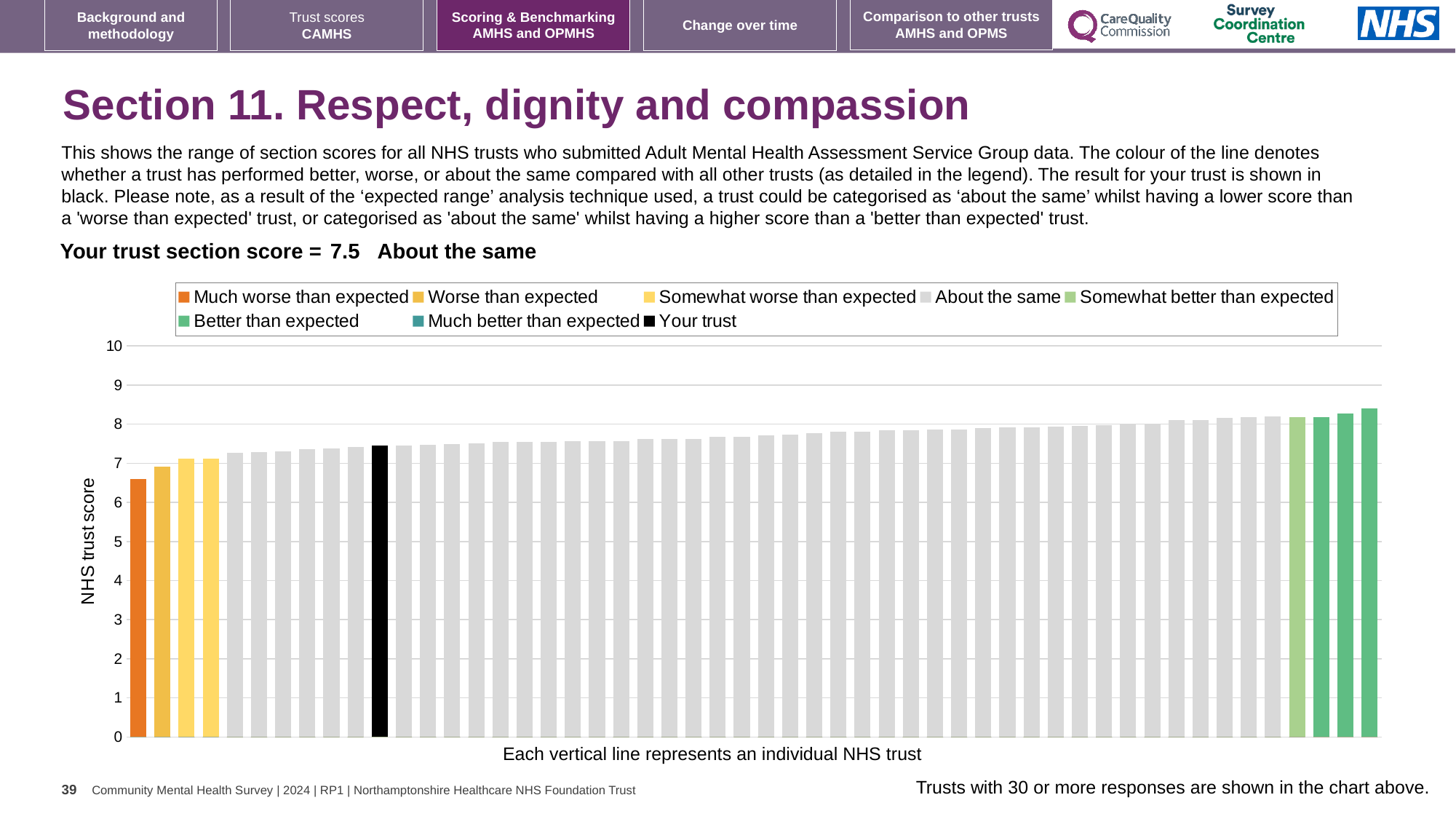
Is the value for the tallest bar greater or less than 9? less Which legend category does the shortest bar belong to? Much worse than expected What is the section score for your trust shown on the slide? 7.5 What is the label on the vertical axis of the chart? NHS trust score Which category is your trust's section score placed in? About the same Do the bar values rise or fall from left to right along the x axis? rise Is the value for the 'Much worse than expected' bar greater or less than 7? less How many entries does the chart legend list? 8 What kind of chart is shown on the slide? bar chart Is the value for your trust's bar greater or less than 7? greater Which legend category does the tallest bar belong to? Better than expected